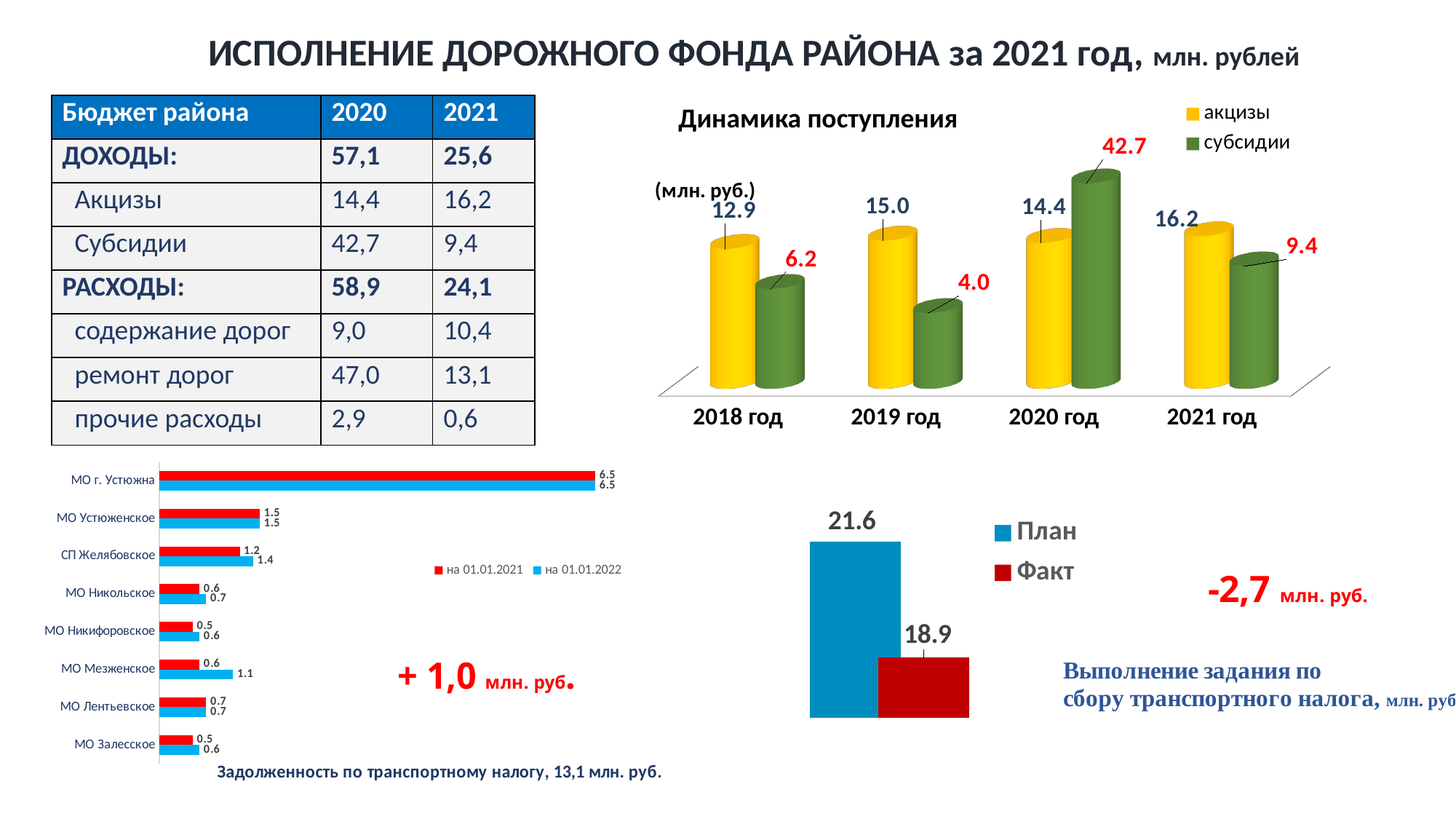
In the 'Динамика поступления' chart, how many series does the legend list? 2 In the bottom-left chart of transport tax debt, what is the value for МО Мезженское на 01.01.2022? 1.1 In the bottom-left chart of transport tax debt, which category has the highest value? МО г. Устюжна In the 'Динамика поступления' chart, what is the value for акцизы in 2021 год? 16.2 In the bottom-left chart of transport tax debt, what kind of chart is it? bar chart In the 'Динамика поступления' chart, which year has the lowest value for субсидии? 2019 год In the 'Динамика поступления' chart, what is the value for субсидии in 2020 год? 42.7 In the bottom-right План/Факт chart, what is the value for Факт? 18.9 In the 'Динамика поступления' chart, how many years are shown on the x axis? 4 In the 'Динамика поступления' chart, what is the difference between акцизы and субсидии in 2021 год? 6.8 In the bottom-left chart of transport tax debt, how many categories are shown? 8 In the bottom-right План/Факт chart, what is the difference between План and Факт? 2.7